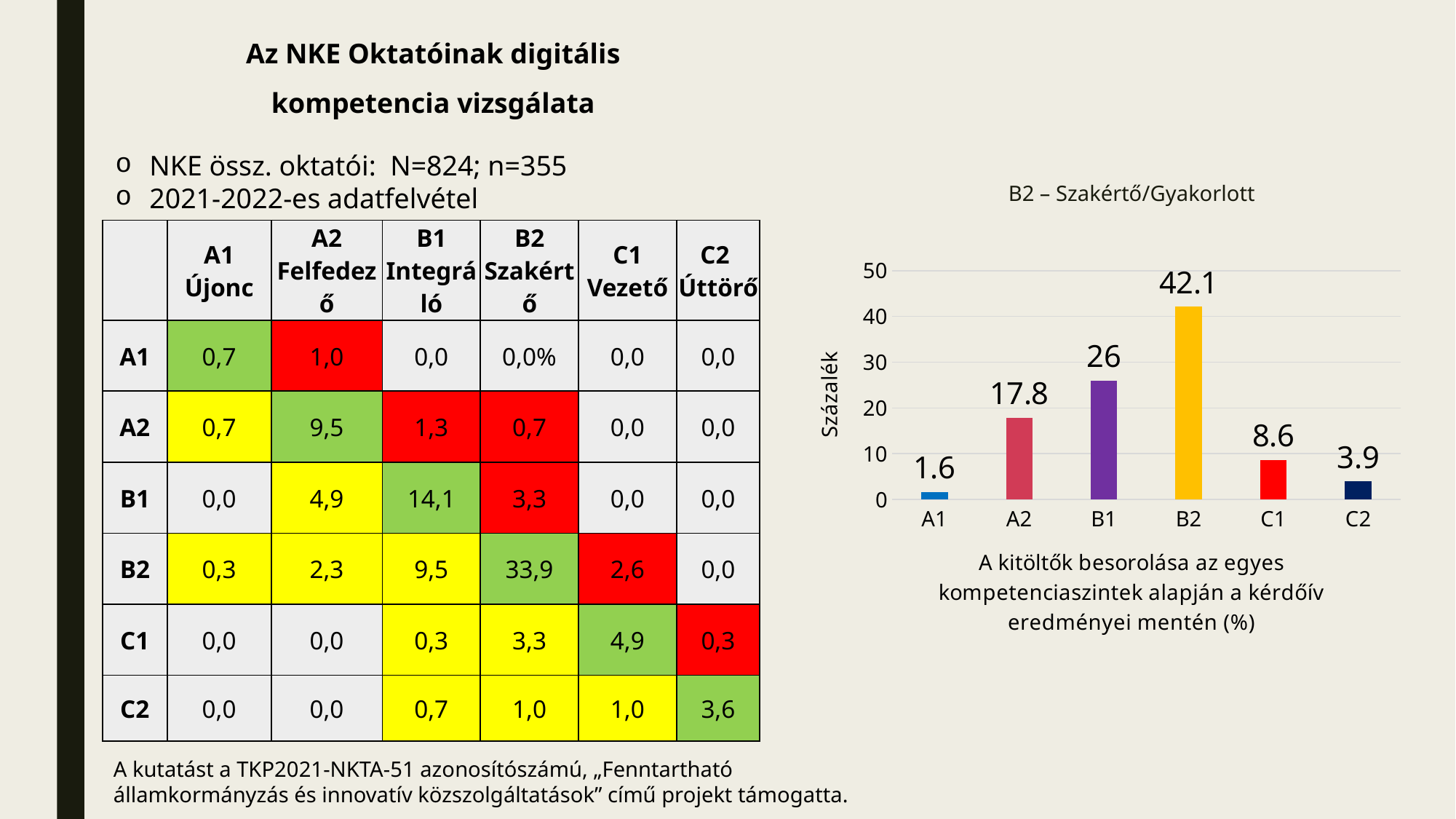
What is the value for C1 in the bar chart? 8.6 What kind of chart is shown on the slide? bar chart Which category has the lowest value in the bar chart? A1 How many categories are shown on the x axis of the bar chart? 6 What is the value for B2 in the bar chart? 42.1 What is the value for A2 in the bar chart? 17.8 Is the value for B1 in the bar chart greater or less than 20? greater What is the difference between the values for C1 and C2 in the bar chart? 4.7 What is the difference between the values for B2 and B1 in the bar chart? 16.1 Which category has the highest value in the bar chart? B2 Which is larger in the bar chart, the value for A2 or the value for C1? A2 What is the label of the vertical axis of the bar chart? Százalék